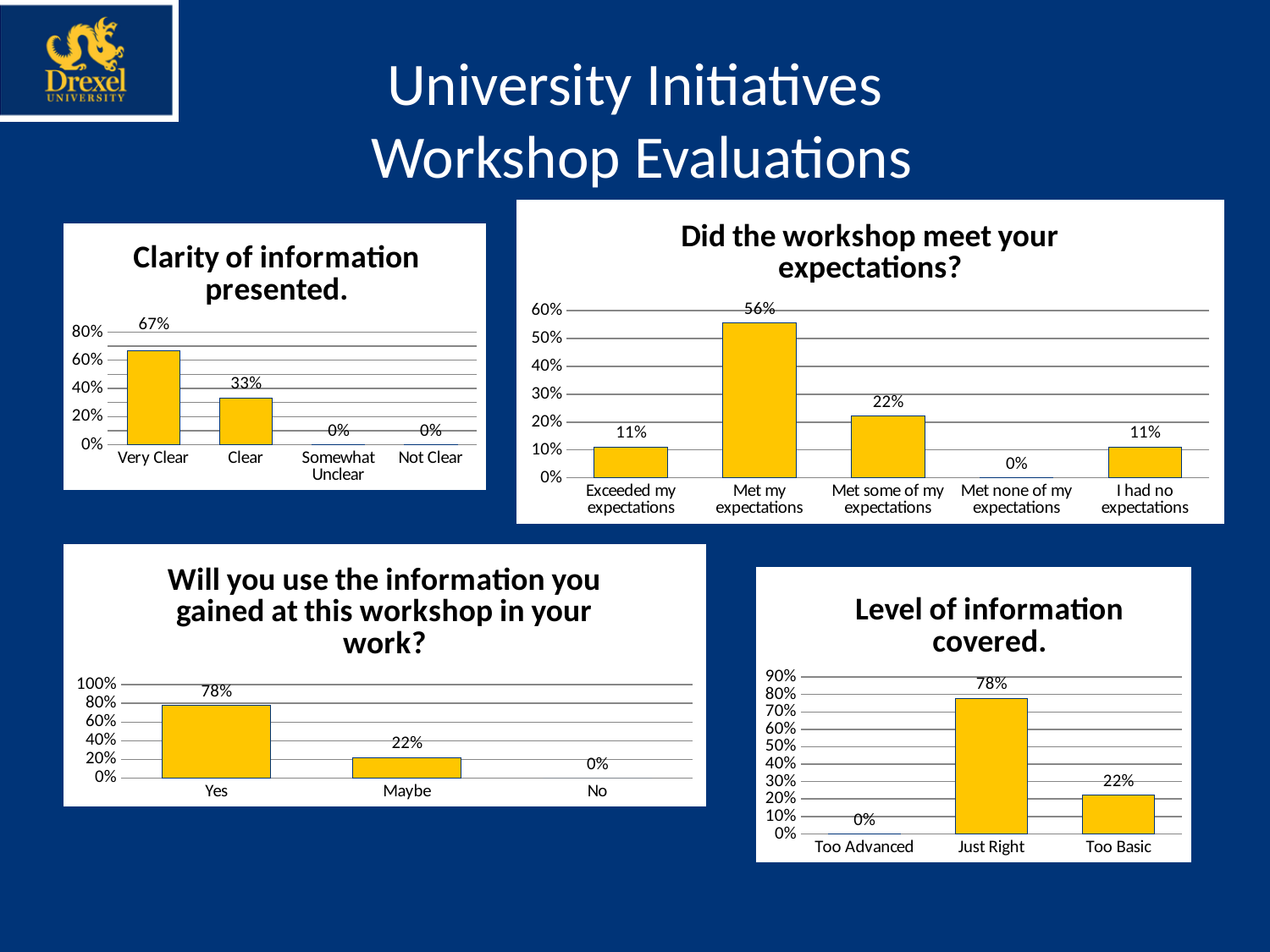
What type of chart is the 'Level of information covered.' chart? Bar chart In the 'Did the workshop meet your expectations?' chart, which category has the highest value? Met my expectations In the 'Clarity of information presented.' chart, what is the value for Very Clear? 67% In the 'Level of information covered.' chart, which category has the lowest value? Too Advanced In the 'Did the workshop meet your expectations?' chart, which is larger: Exceeded my expectations or Met some of my expectations? Met some of my expectations In the 'Clarity of information presented.' chart, what is the difference between Very Clear and Clear? 34% In the 'Did the workshop meet your expectations?' chart, how many categories are shown on the x axis? 5 In the 'Level of information covered.' chart, what is the value for Too Basic? 22% In the 'Will you use the information you gained at this workshop in your work?' chart, what is the value for Yes? 78% In the 'Clarity of information presented.' chart, which category has the highest value? Very Clear In the 'Will you use the information you gained at this workshop in your work?' chart, what is the difference between Yes and Maybe? 56% In the 'Did the workshop meet your expectations?' chart, what is the value for Met some of my expectations? 22%